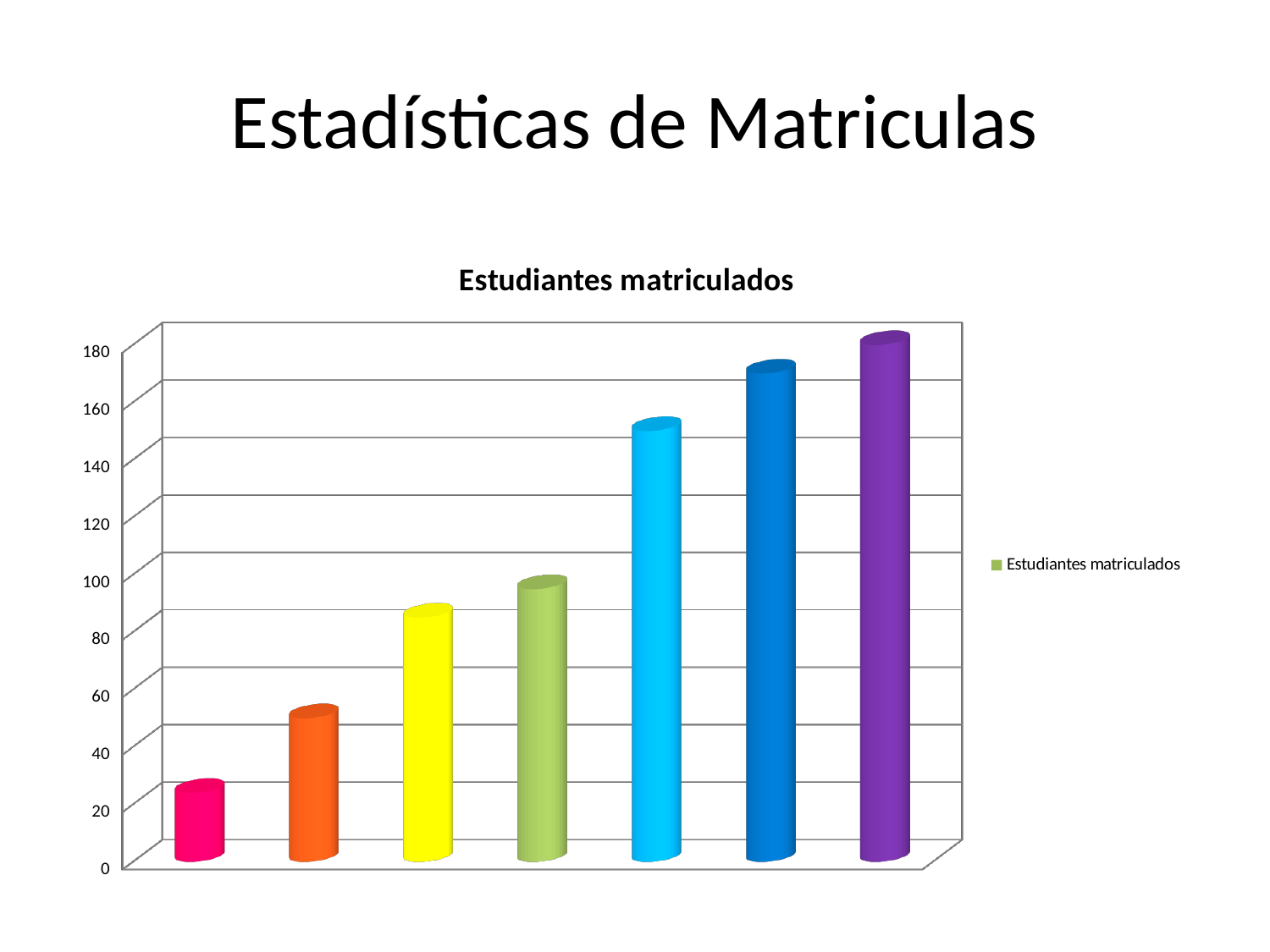
Is the value of the purple (rightmost) bar greater or less than 160? greater What is the title of the chart? Estudiantes matriculados Which is larger, the value of the yellow bar or the value of the orange bar? the yellow bar Do the bar values rise or fall from left to right? rise Which bar is the shortest? the pink bar (leftmost) What kind of chart is shown on the slide? bar chart How many series does the legend list? 1 Is the value of the pink (leftmost) bar greater or less than 40? less Is the value of the orange bar greater or less than 40? greater Which bar is the tallest? the purple bar (rightmost) How many bars are plotted in the chart? 7